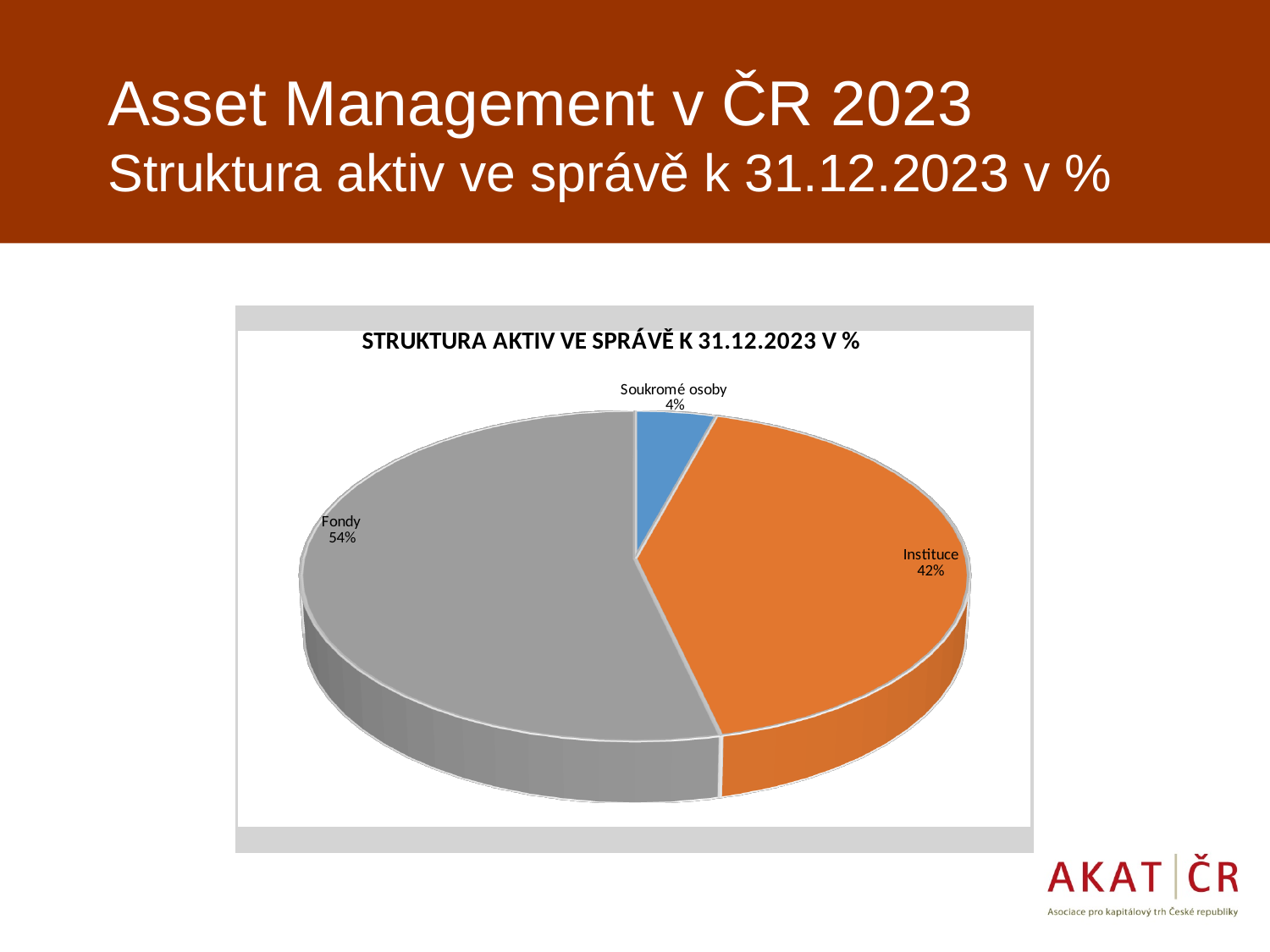
What colour is the Instituce slice? Orange How many categories are shown in the pie chart? 3 What is the share for Fondy? 54% Which category has the largest share of the pie? Fondy Which is larger, the share for Fondy or the share for Instituce? Fondy What type of chart is shown on the slide? Pie chart What is the difference in percentage points between Fondy and Instituce? 12 What is the difference in percentage points between Instituce and Soukromé osoby? 38 What is the share for Soukromé osoby? 4% What is the title of the chart? STRUKTURA AKTIV VE SPRÁVĚ K 31.12.2023 V % What is the share for Instituce? 42% Which category has the smallest share of the pie? Soukromé osoby